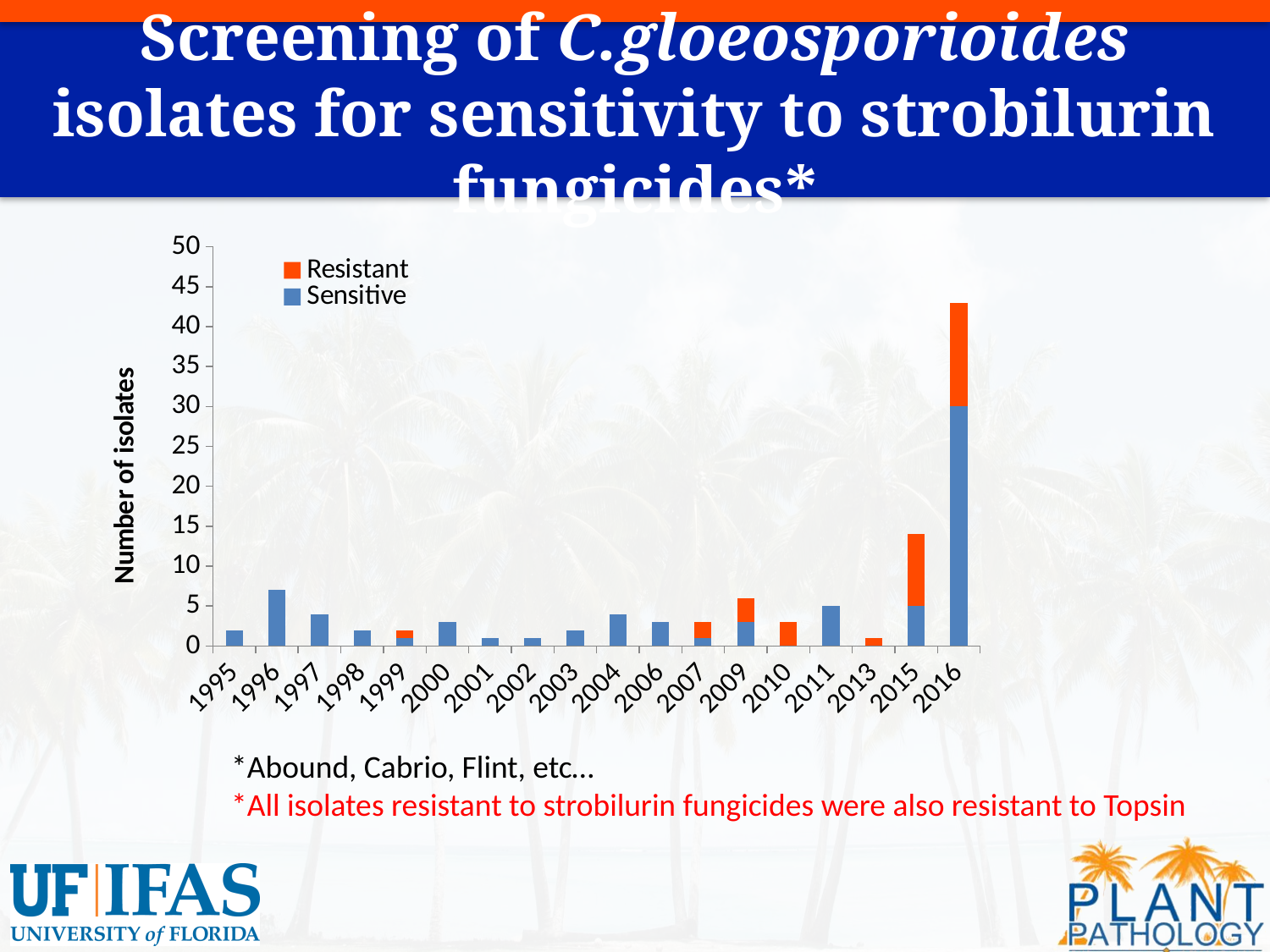
How many years are shown along the x axis of the chart? 18 What is the label on the vertical axis of the chart? Number of isolates Is the number of isolates for 2010 greater or less than 5? less Which year has the tallest bar in the chart? 2016 What kind of chart is shown on the slide? Bar chart Which legend entry is shown in orange in the chart? Resistant Is the total number of isolates for 2016 greater or less than 40? greater How many series does the chart's legend list? 2 Which year has the larger total number of isolates, 2015 or 2016? 2016 Is the number of isolates for 1996 greater or less than 5? greater Which year has the larger number of isolates, 1995 or 1996? 1996